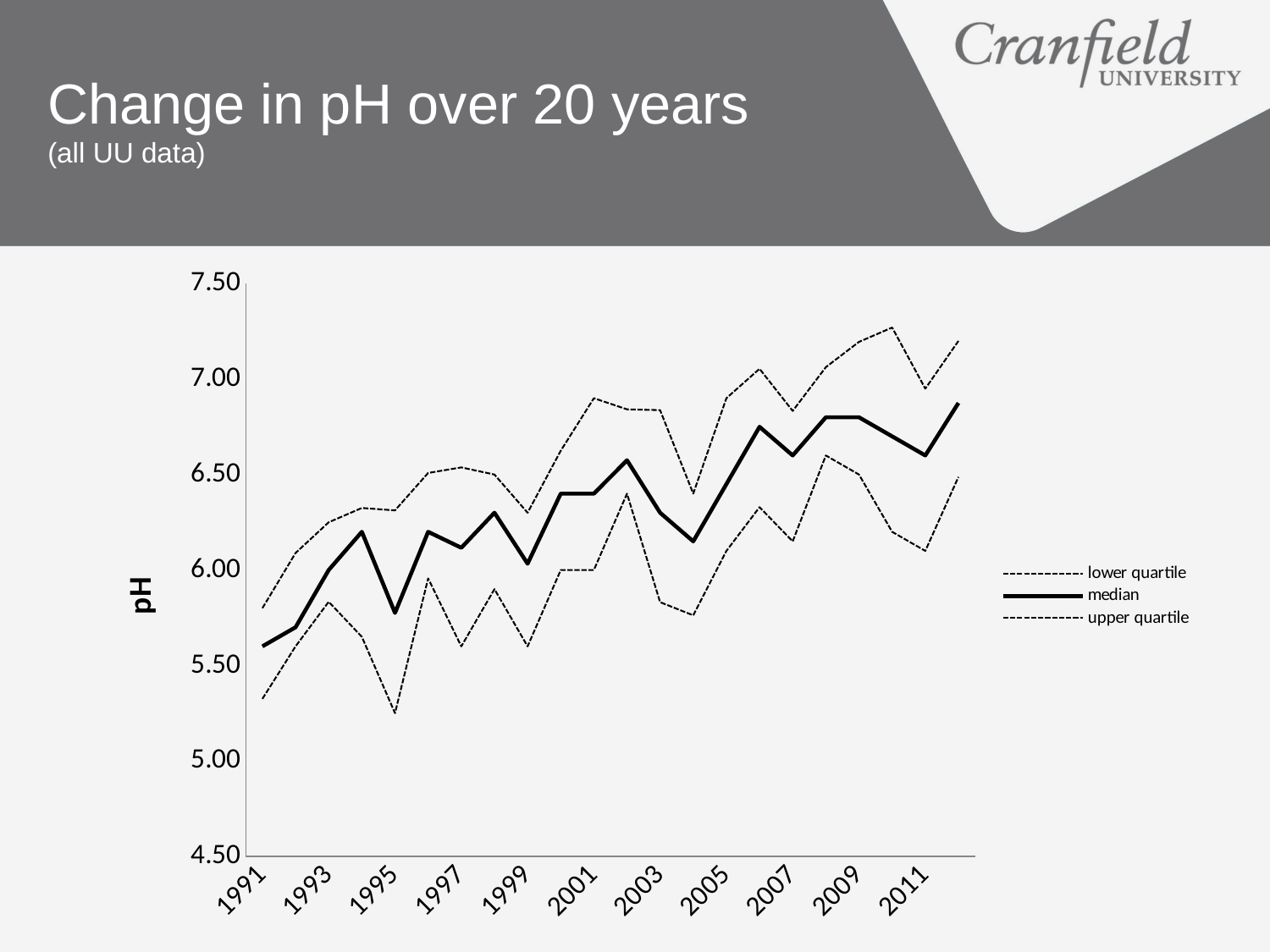
Is the lower quartile value for 1995 greater or less than 5.50? less Is the upper quartile value for 2009 greater or less than 7.00? greater Is the median value for 2011 greater or less than 6.50? greater Which year has the lowest median pH? 1991 What kind of chart is shown on the slide? line chart Does the median pH generally rise or fall from 1991 to 2011? rise What is the label on the vertical axis? pH How many series does the legend list? 3 Is the median pH larger in 1991 or in 2011? 2011 What are the three series named in the legend? lower quartile, median, upper quartile